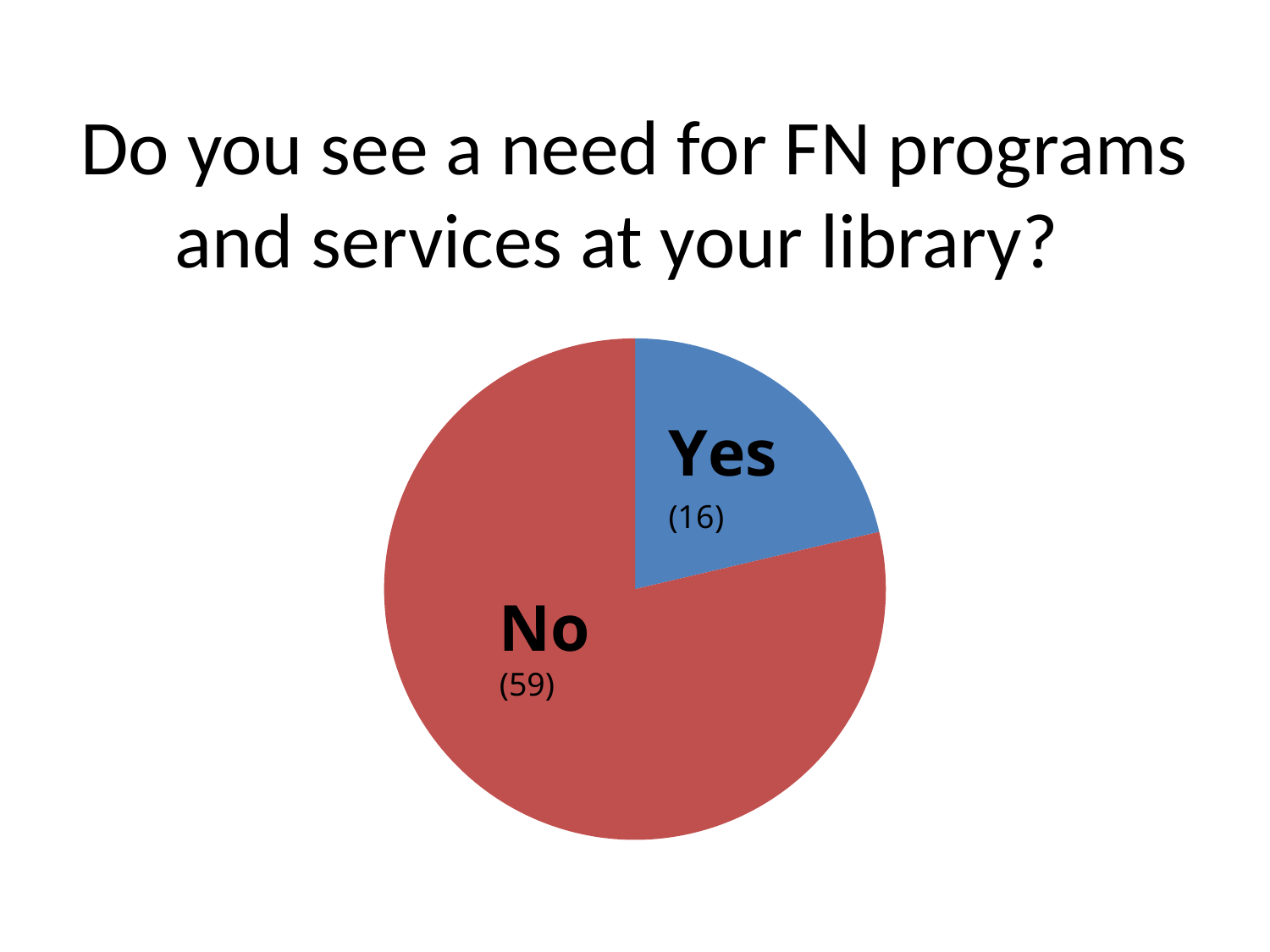
How many slices does the pie chart have? 2 Which response has the smallest slice of the pie? Yes What type of chart is shown on the slide? pie chart What colour is the No slice of the pie chart? red How many respondents answered "Yes" to seeing a need for FN programs and services at their library? 16 What question does the slide title ask? Do you see a need for FN programs and services at your library? How many respondents answered "No"? 59 Is the number of Yes responses larger or smaller than the number of No responses? smaller Which response has the larger slice of the pie, Yes or No? No How many more respondents answered No than Yes? 43 What is the total number of responses shown in the pie chart? 75